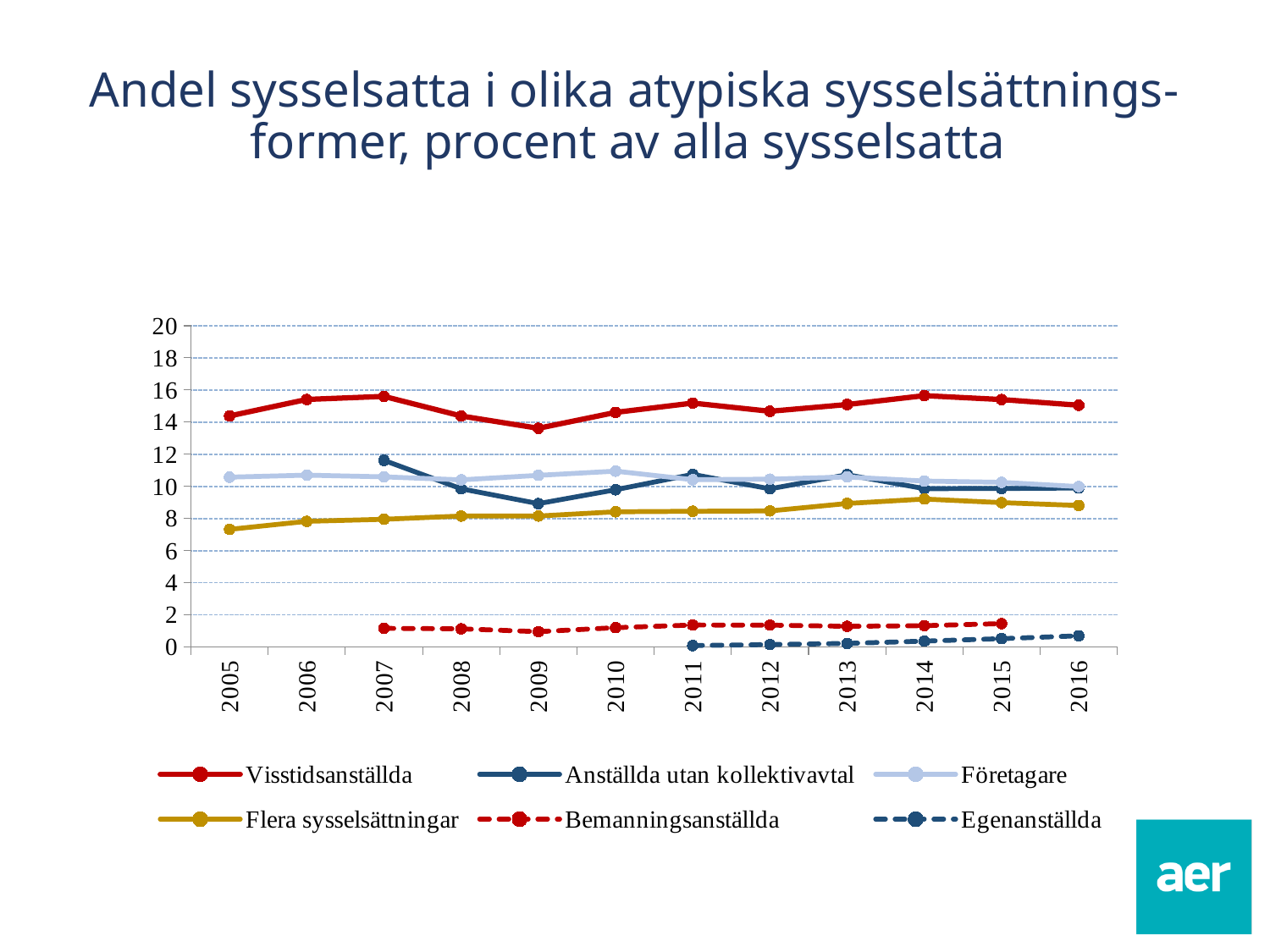
What kind of chart is shown on the slide? line chart Which series has the lowest value in 2016? Egenanställda In 2007, which is higher: Anställda utan kollektivavtal or Företagare? Anställda utan kollektivavtal Which series has the highest values across all years? Visstidsanställda Is the value for Företagare in 2010 greater or less than 10? greater In which year does the Bemanningsanställda series first appear? 2007 Is the value for Flera sysselsättningar in 2005 greater or less than 8? less Is the value for Bemanningsanställda in 2015 greater or less than 2? less Do the values for Egenanställda rise or fall from 2011 to 2016? rise How many years are shown on the x axis? 12 How many series does the legend list? 6